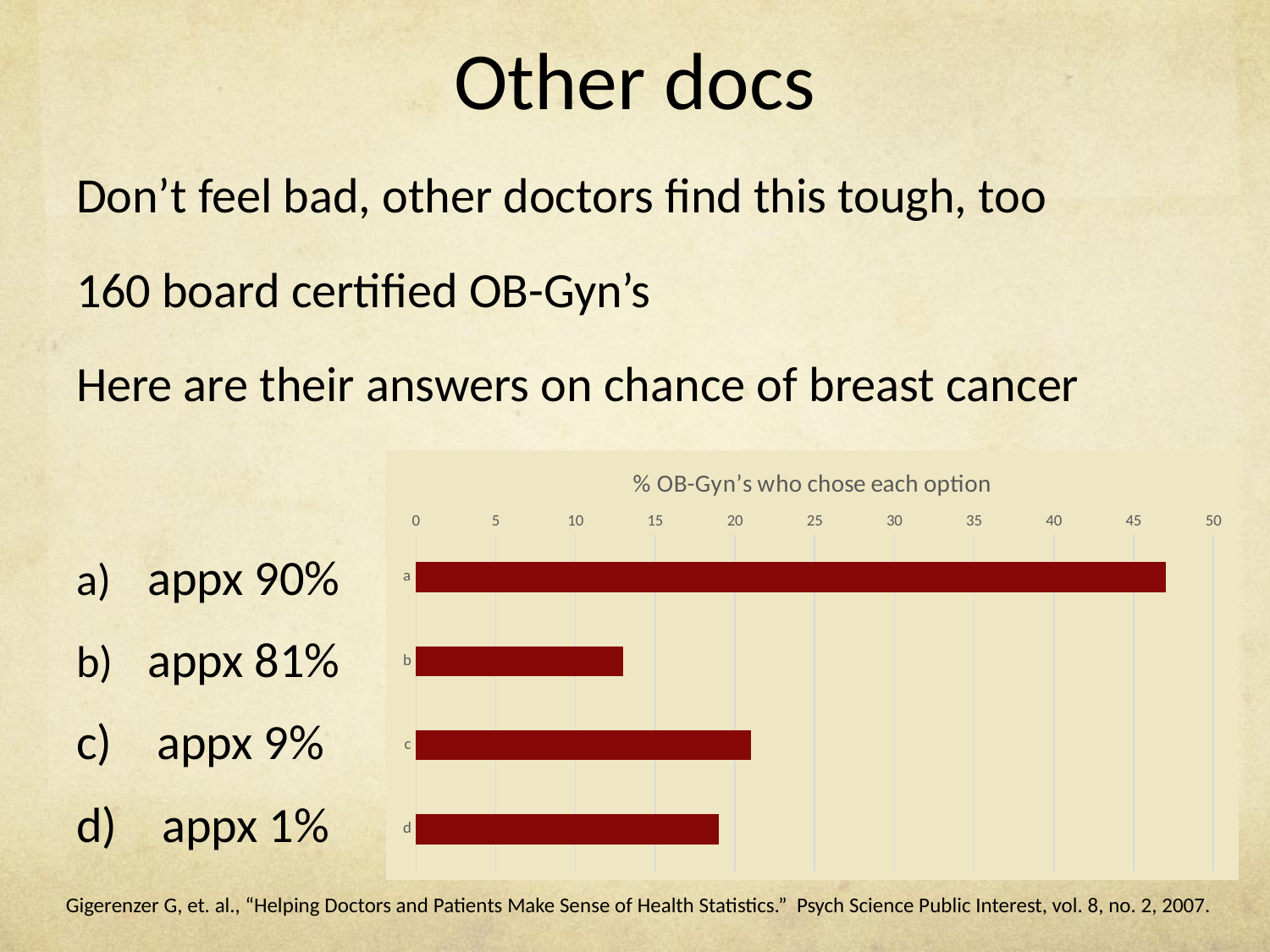
How many categories are plotted in the chart? 4 Which is larger, the value for option b or the value for option d? d Is the value for option d greater or less than 25? less Which option has the highest percentage of OB-Gyn's choosing it? a Which is larger, the value for option a or the value for option c? a Is the value for option c greater or less than 15? greater What is the title of the chart? % OB-Gyn's who chose each option Is the value for option b greater or less than 15? less What kind of chart is shown on the slide? bar chart Which option has the lowest percentage of OB-Gyn's choosing it? b What colour are the bars in the chart? dark red